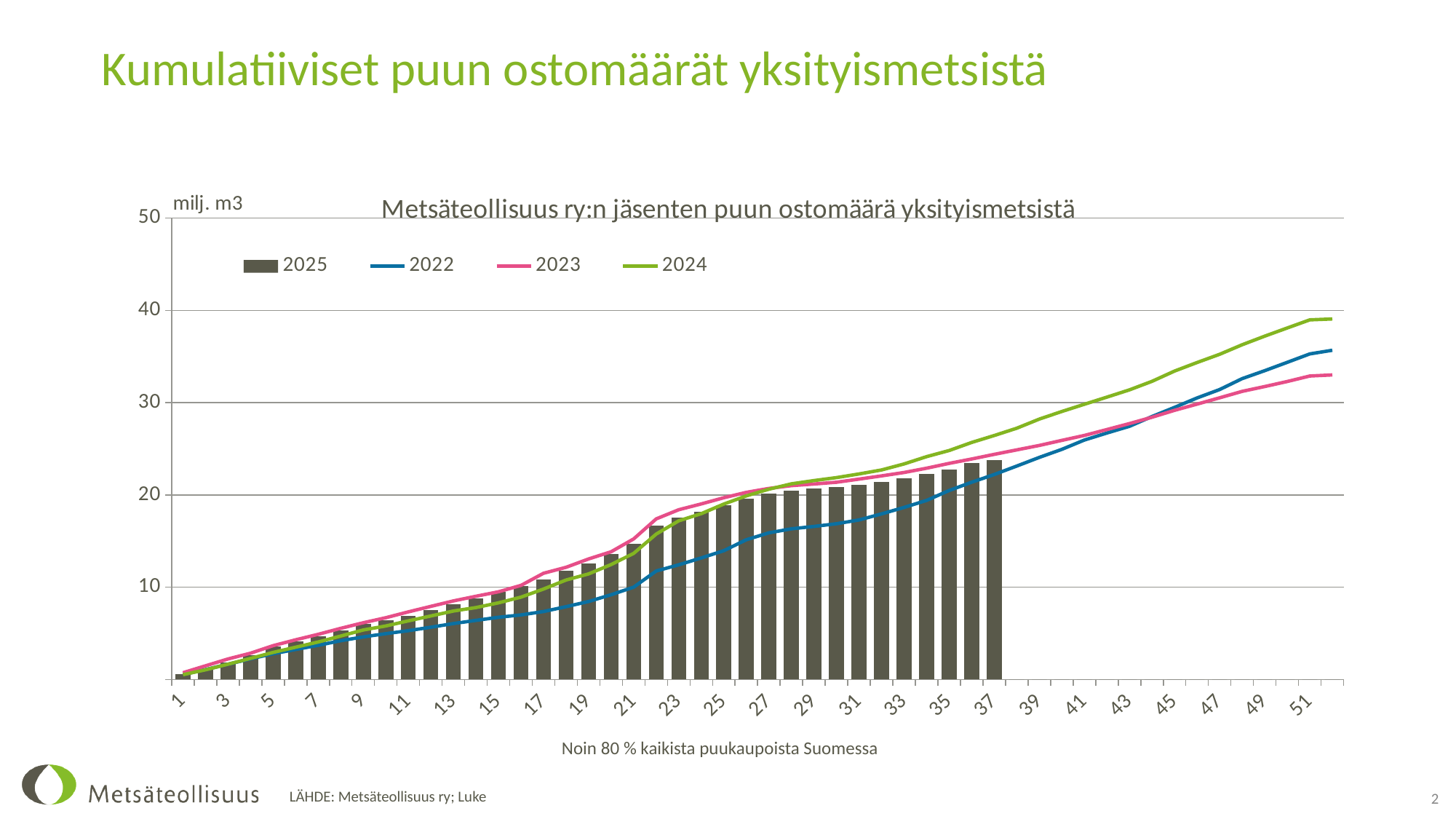
Is the last 2025 bar (around week 37–38) greater or less than 20? greater What unit is shown at the top of the vertical axis? milj. m3 Do the values of the series rise or fall along the x axis? rise Around week 37, which is larger: the 2025 bar or the 2022 line? 2025 bar How many series does the chart legend list? 4 What kind of chart is shown on the slide? A combined bar and line chart Which series has the lowest value at the right end of the chart (week 51–52)? 2023 Which series is drawn as bars rather than a line? 2025 At the right end of the chart, is the 2024 line greater or less than 30? greater At the right end of the chart, is the 2024 line greater or less than 40? less Around week 30, which series has the lowest value? 2022 Which series has the highest value at the right end of the chart (week 51–52)? 2024